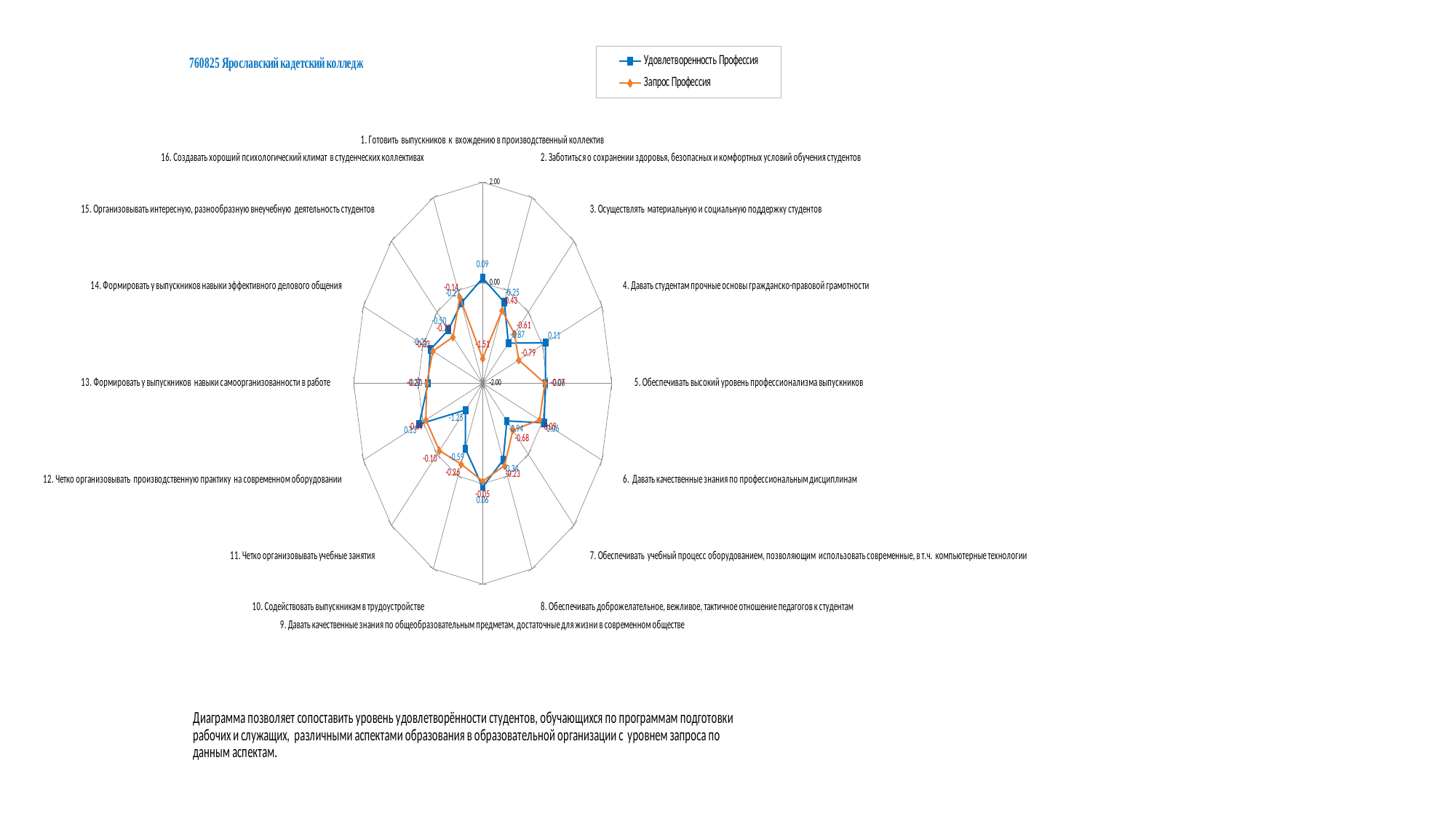
What is the title of the chart? 760825 Ярославский кадетский колледж Which series is drawn with orange diamond markers? Запрос Профессия What is the value of 'Запрос Профессия' for category 1 (Готовить выпускников к вхождению в производственный коллектив)? -1.51 What is the value of 'Удовлетворенность Профессия' for category 1 (Готовить выпускников к вхождению в производственный коллектив)? 0.09 What is the difference between 'Удовлетворенность Профессия' (0.11) and 'Запрос Профессия' (-0.79) for category 4? 0.90 What is the value of 'Удовлетворенность Профессия' for category 11 (Четко организовывать учебные занятия)? -1.25 For category 4 (Давать студентам прочные основы гражданско-правовой грамотности), which series has the larger value: 'Удовлетворенность Профессия' or 'Запрос Профессия'? Удовлетворенность Профессия What is the value of 'Запрос Профессия' for category 4 (Давать студентам прочные основы гражданско-правовой грамотности)? -0.79 What kind of chart is shown on the slide? Radar chart How many series does the legend list? 2 What is the value of 'Удовлетворенность Профессия' for category 4 (Давать студентам прочные основы гражданско-правовой грамотности)? 0.11 How many categories (axes) does the radar chart have? 16